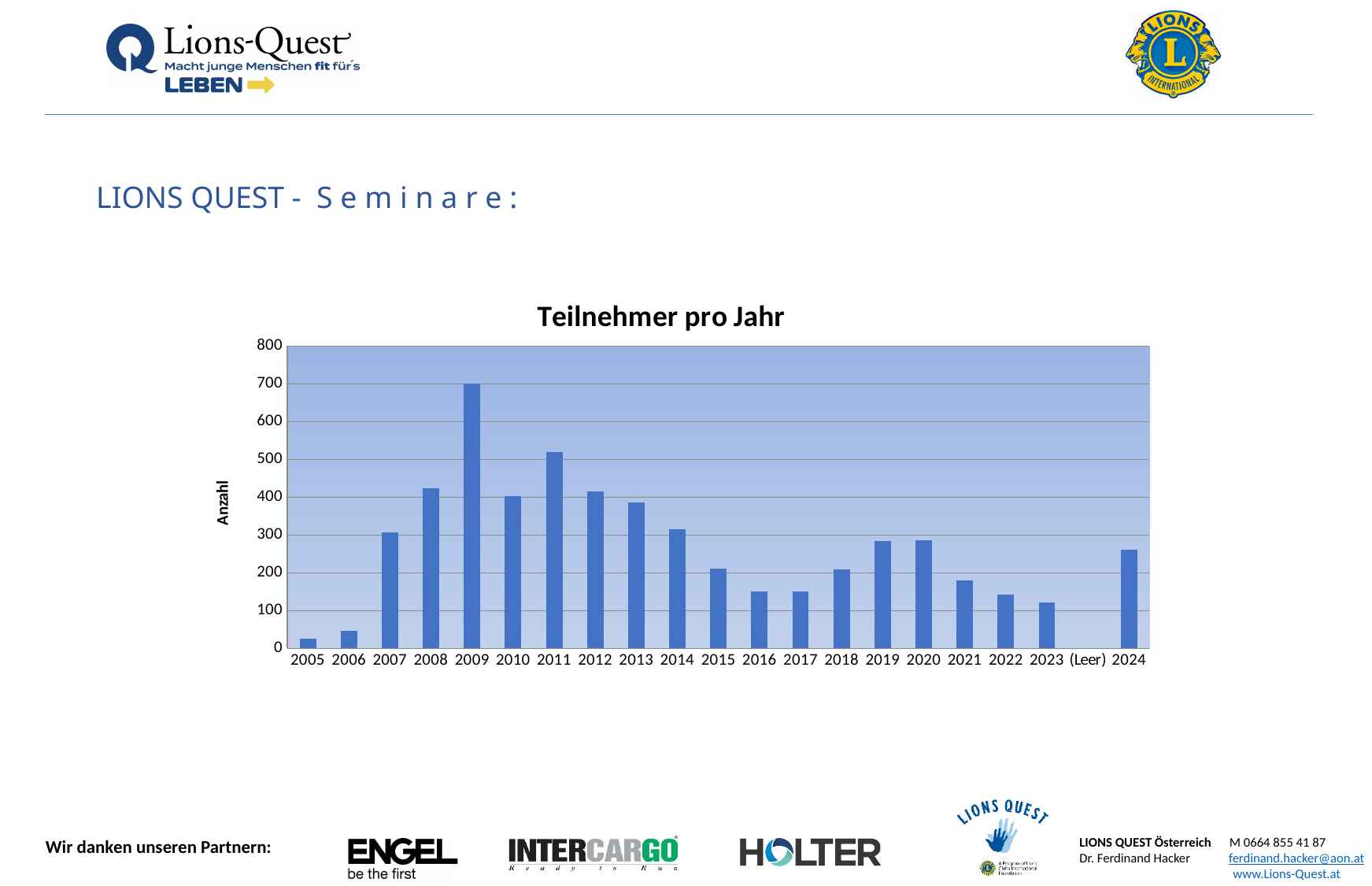
Do the values generally rise or fall from 2005 to 2009? rise What kind of chart is shown on the slide? bar chart Is the value for 2006 greater or less than 100? less Which has the larger value, 2009 or 2011? 2009 What is the title of the chart? Teilnehmer pro Jahr Excluding the empty (Leer) category, which year has the lowest value in the chart? 2005 What is the label on the vertical axis of the chart? Anzahl Is the value for 2024 greater or less than 200? greater Which category has the highest value in the chart? 2009 Is the value for 2016 greater or less than 200? less How many categories are shown along the x axis of the chart? 21